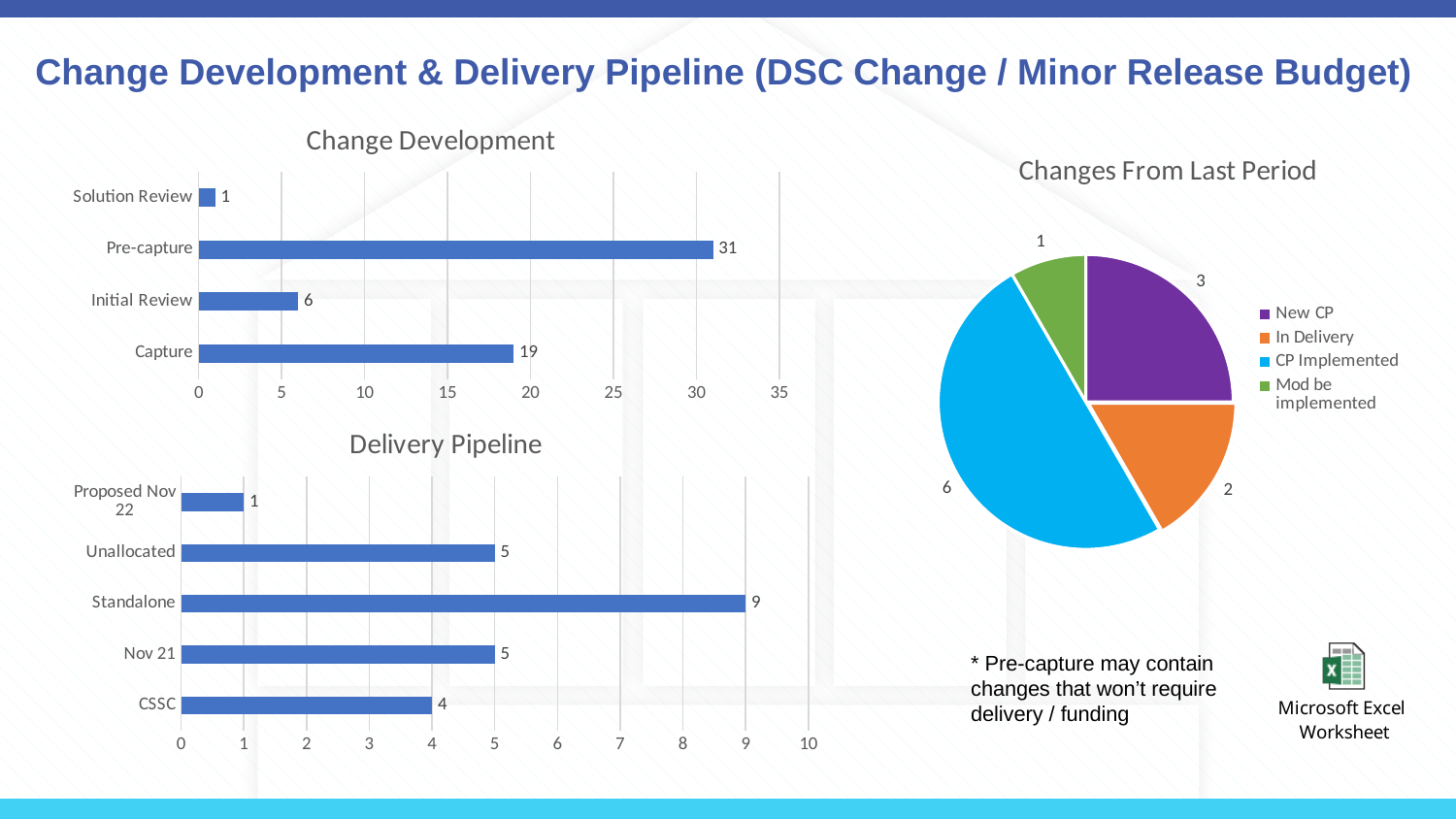
In the Delivery Pipeline chart, which is larger, Unallocated or CSSC? Unallocated In the Change Development chart, which category has the lowest value? Solution Review In the Changes From Last Period chart, what is the value for In Delivery? 2 In the Delivery Pipeline chart, what is the value for CSSC? 4 In the Change Development chart, how many categories are shown? 4 In the Delivery Pipeline chart, which category has the highest value? Standalone How many entries does the legend of the Changes From Last Period chart list? 4 What kind of chart is the Delivery Pipeline chart? Bar chart In the Change Development chart, what is the difference between Pre-capture and Capture? 12 In the Changes From Last Period chart, what share of the total does CP Implemented represent? 50% In the Delivery Pipeline chart, how many categories are shown? 5 In the Change Development chart, what is the value for Pre-capture? 31